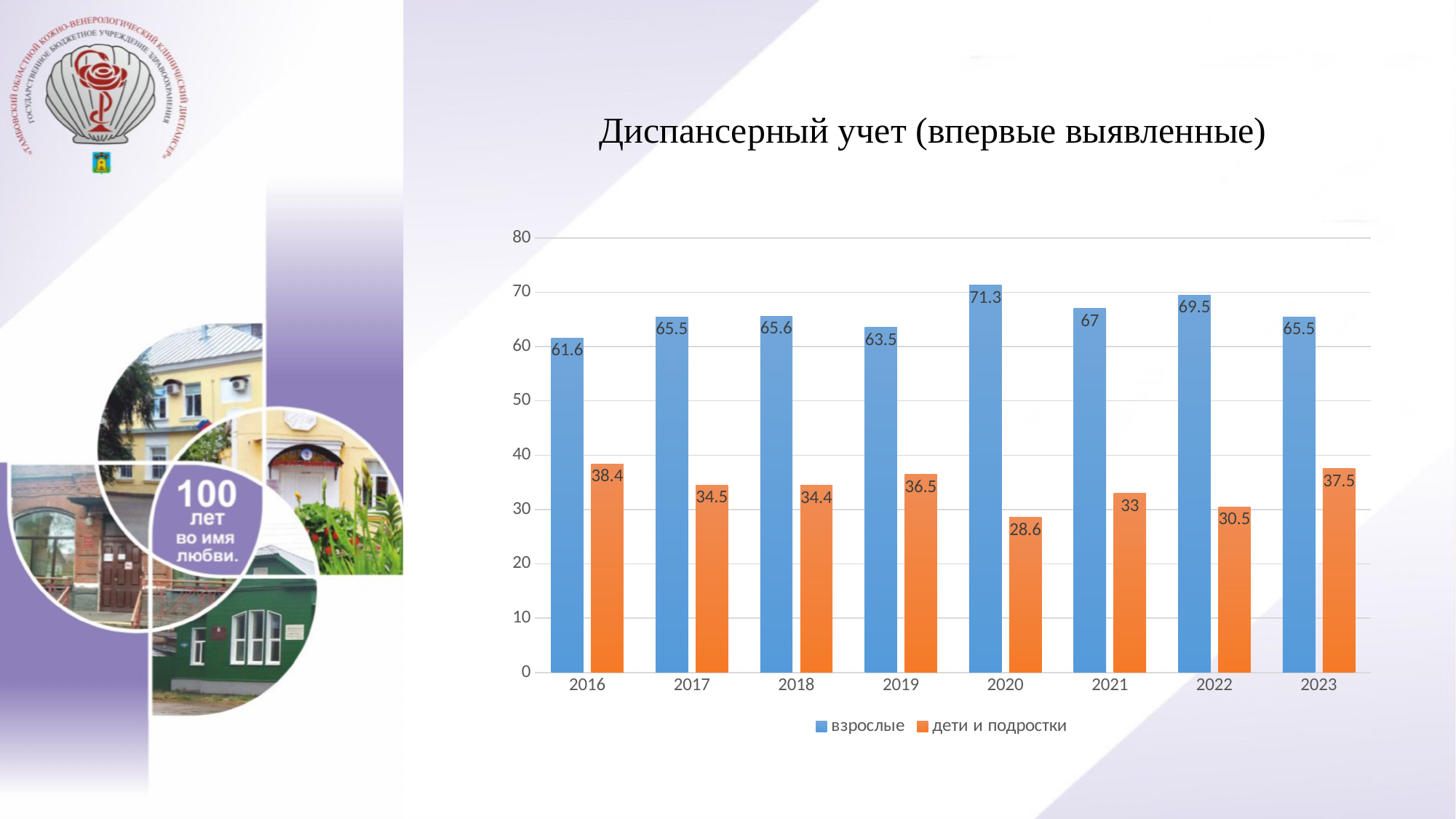
In which year is the value for взрослые highest? 2020 What is the value for дети и подростки in 2016? 38.4 What kind of chart is shown on the slide? bar chart In which year is the value for дети и подростки lowest? 2020 What is the value for дети и подростки in 2023? 37.5 Which is larger: the value for дети и подростки in 2019 or in 2022? 2019 What is the difference between the взрослые and дети и подростки values in 2021? 34 Is the value for взрослые in 2016 greater or less than 60? greater How many years are shown on the x axis? 8 What is the title of the chart? Диспансерный учет (впервые выявленные) How many series does the legend list? 2 What is the value for взрослые in 2020? 71.3